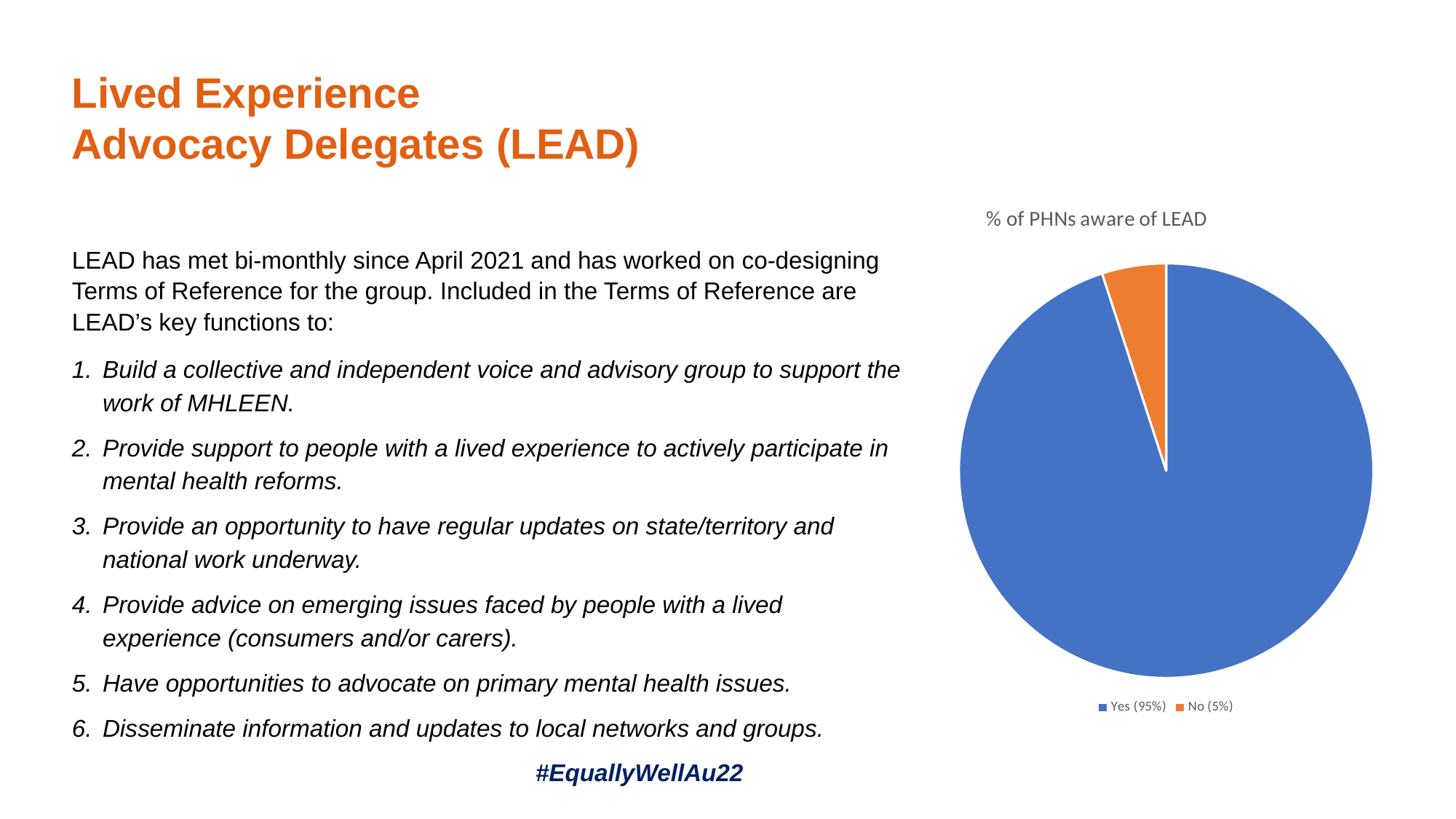
Which category has the largest slice of the pie? Yes What kind of chart is shown on the slide? pie chart What is the title of the chart? % of PHNs aware of LEAD What share of PHNs answered No to being aware of LEAD? 5% How many slices does the pie chart have? 2 What is the difference in percentage points between the Yes and No slices? 90 What share of PHNs answered Yes to being aware of LEAD? 95% What colour is the No slice in the pie chart? orange Which category has the smallest slice of the pie? No Which is larger, the Yes slice or the No slice? Yes How many entries does the legend list? 2